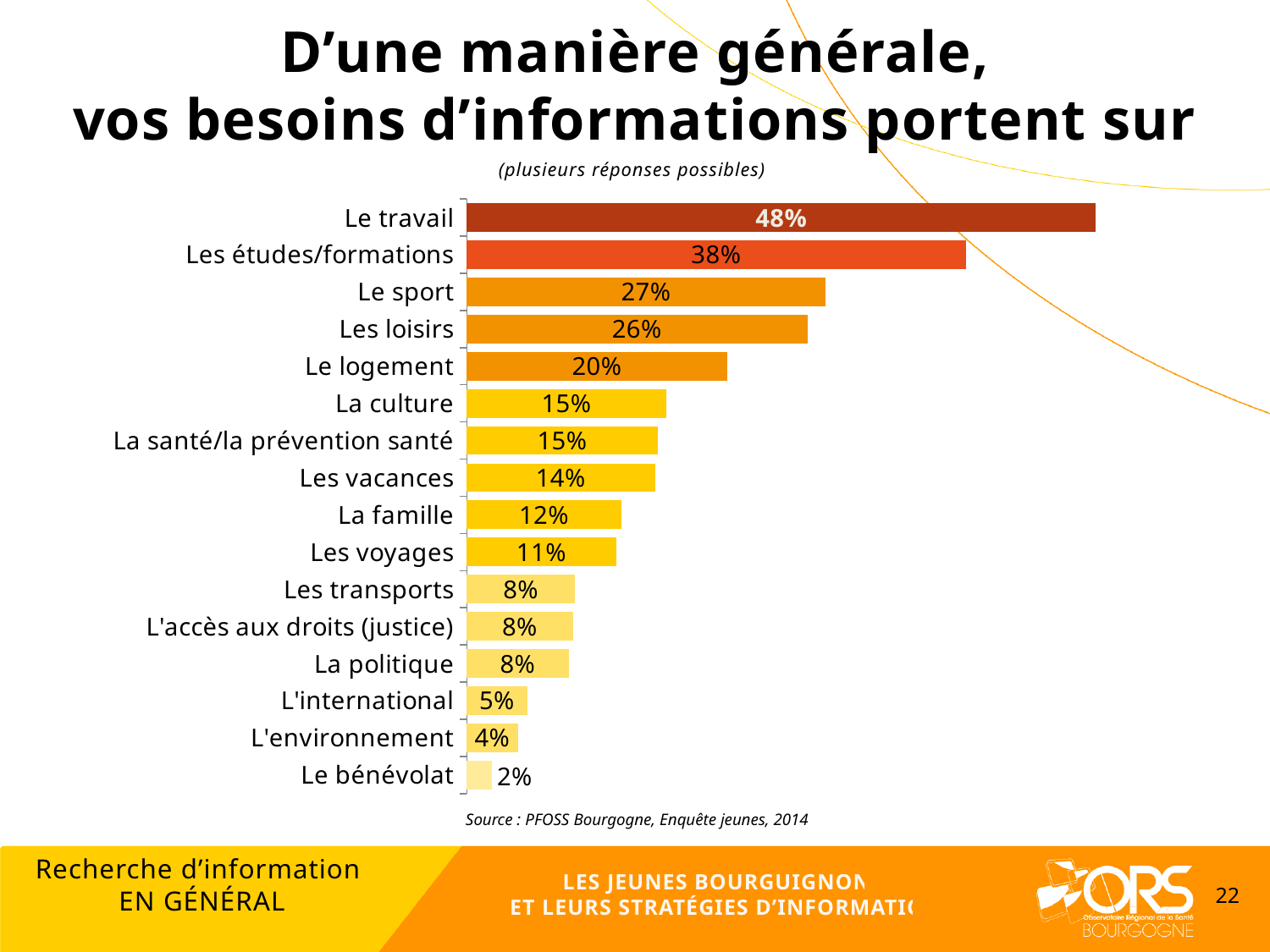
What is the difference between the values for Le sport and Le logement? 7% What is the value for Le logement? 20% What is the difference between the values for Le travail and Les études/formations? 10% What is the value for Les études/formations? 38% What source is cited below the chart? PFOSS Bourgogne, Enquête jeunes, 2014 What is the value for Le travail? 48% Which category has the highest value? Le travail What is the value for Les vacances? 14% Which category has the lowest value? Le bénévolat How many categories are shown in the chart? 16 What kind of chart is shown on the slide? Bar chart Which is larger, the value for Les loisirs or the value for La famille? Les loisirs